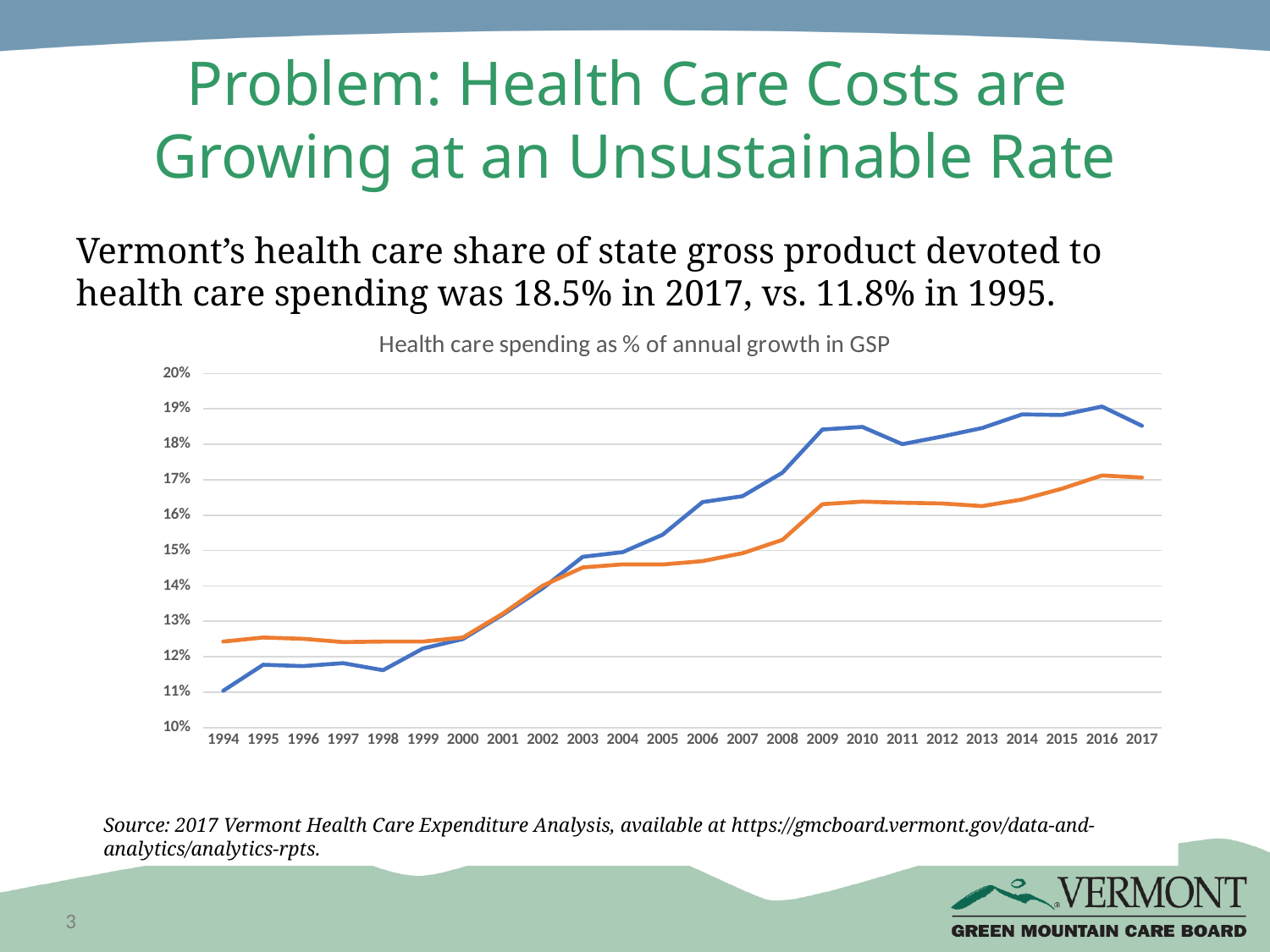
In which year does the blue line have its lowest value? 1994 In 1995, which line has the higher value, the blue line or the orange line? the orange line In 2017, which line has the higher value, the blue line or the orange line? the blue line What is the title of the chart? Health care spending as % of annual growth in GSP In which year does the blue line reach its highest value? 2016 How many years are plotted along the x axis of the chart? 24 Is the value of the blue line in 1994 greater or less than 12%? less What kind of chart is shown on the slide? line chart Overall, do the values of the blue line rise or fall from 1994 to 2017? rise How many lines are plotted on the chart? 2 Is the value of the blue line in 2017 greater or less than 18%? greater Is the value of the orange line in 2009 greater or less than 16%? greater